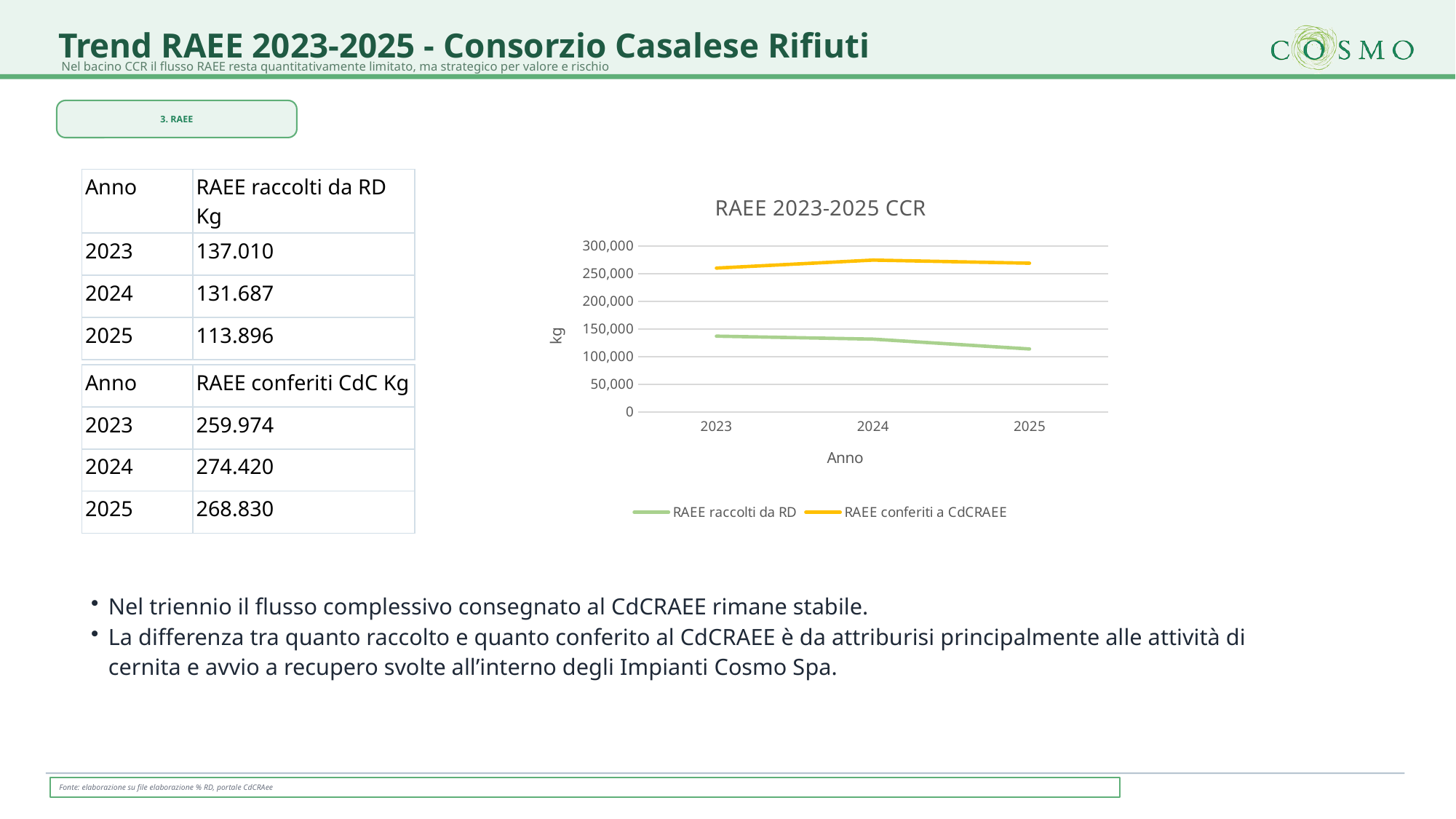
Is the value for 'RAEE conferiti a CdCRAEE' in 2024 greater or less than 250,000? greater In which year is the 'RAEE conferiti a CdCRAEE' series highest? 2024 Does the 'RAEE raccolti da RD' series rise or fall from 2023 to 2025? fall In 2025, which series has the larger value, 'RAEE raccolti da RD' or 'RAEE conferiti a CdCRAEE'? RAEE conferiti a CdCRAEE How many years are plotted along the x axis of the chart? 3 Using the table values, what is the difference between RAEE conferiti CdC in 2024 and in 2023? 14.446 Is the value for 'RAEE raccolti da RD' in 2025 greater or less than 150,000? less How many series does the legend of the chart list? 2 What kind of chart is shown on the slide? line chart What is the label of the y axis of the chart? kg According to the table on the slide, how many kg of RAEE were collected from RD (raccolti da RD) in 2023? 137.010 In which year is the 'RAEE raccolti da RD' series lowest? 2025